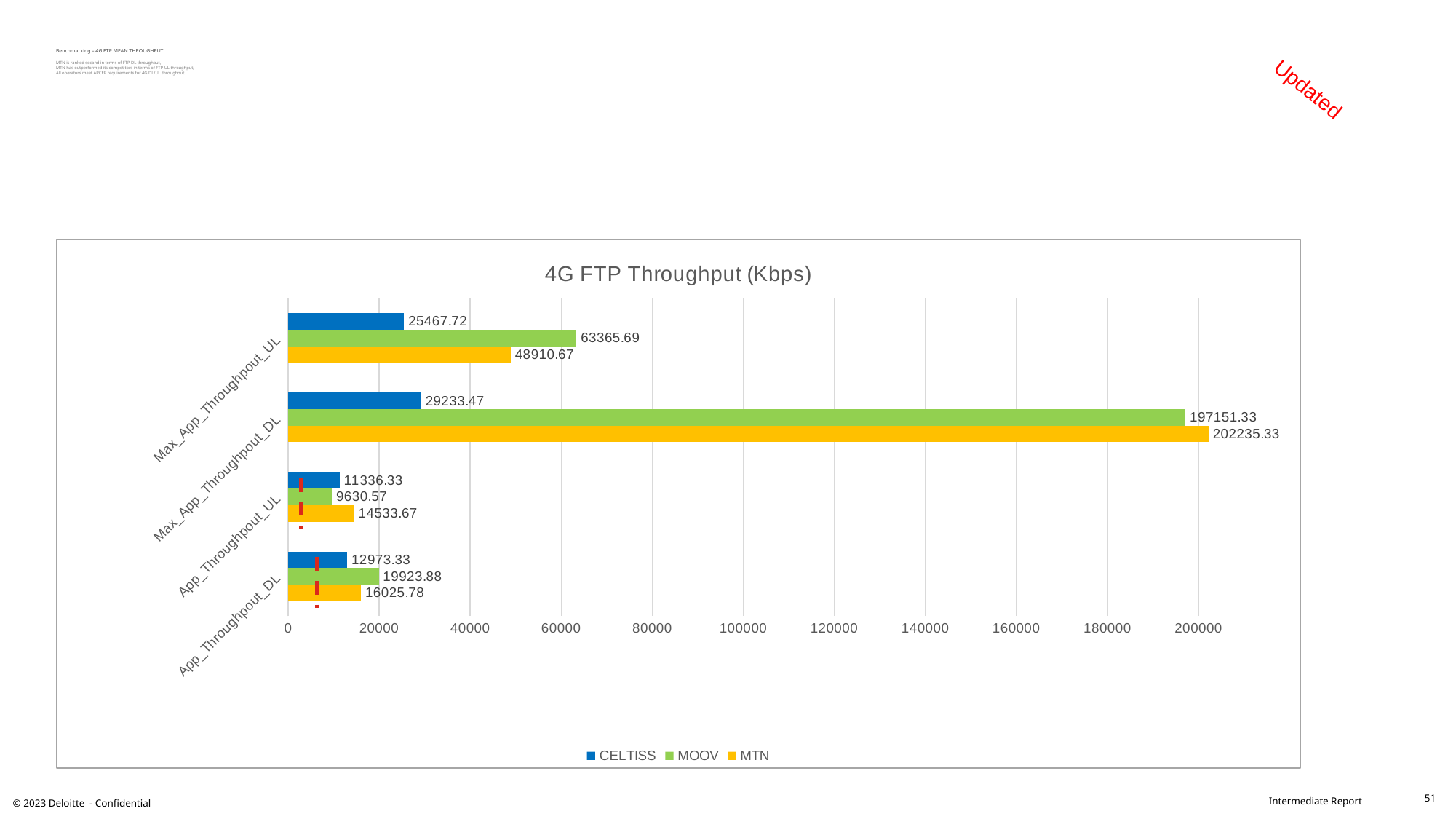
How many series does the legend list? 3 Which operator has the lowest value for App_Throughpout_UL? MOOV What is the difference between the MTN and MOOV values for Max_App_Throughpout_DL? 5084.00 What is the title of the chart? 4G FTP Throughput (Kbps) Is the MOOV value for Max_App_Throughpout_DL greater or less than 180000? greater What is the MOOV value for Max_App_Throughpout_UL? 63365.69 What is the CELTISS value for App_Throughpout_UL? 11336.33 Which is larger for Max_App_Throughpout_UL: the MTN value or the CELTISS value? MTN What is the MTN value for Max_App_Throughpout_DL? 202235.33 Which operator has the highest value for App_Throughpout_DL? MOOV What kind of chart is shown? bar chart How many categories are shown on the y axis? 4